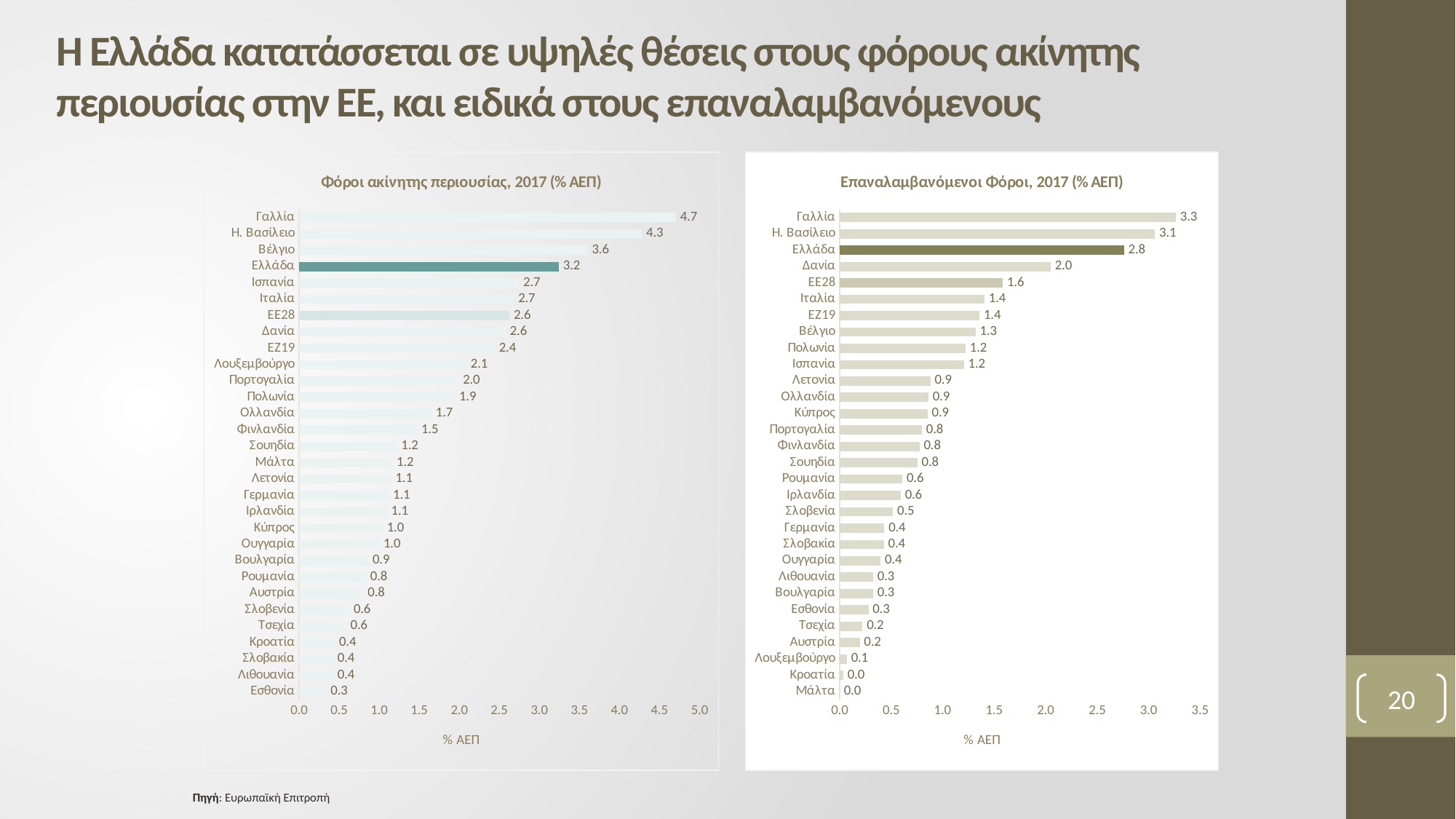
In the chart 'Επαναλαμβανόμενοι Φόροι, 2017 (% ΑΕΠ)', which is larger, Δανία or Ιταλία? Δανία In the chart 'Φόροι ακίνητης περιουσίας, 2017 (% ΑΕΠ)', which country has the highest value? Γαλλία In the chart 'Επαναλαμβανόμενοι Φόροι, 2017 (% ΑΕΠ)', what is the value for ΕΖ19? 1.4 What kind of chart is 'Επαναλαμβανόμενοι Φόροι, 2017 (% ΑΕΠ)'? Bar chart In the chart 'Φόροι ακίνητης περιουσίας, 2017 (% ΑΕΠ)', what is the value for Ελλάδα? 3.2 In the chart 'Φόροι ακίνητης περιουσίας, 2017 (% ΑΕΠ)', which is larger, Βέλγιο or Ισπανία? Βέλγιο In the chart 'Επαναλαμβανόμενοι Φόροι, 2017 (% ΑΕΠ)', which category has the lowest value? Μάλτα and Κροατία (both 0.0) In the chart 'Επαναλαμβανόμενοι Φόροι, 2017 (% ΑΕΠ)', what is the value for Ελλάδα? 2.8 What is the x-axis label of the chart 'Φόροι ακίνητης περιουσίας, 2017 (% ΑΕΠ)'? % ΑΕΠ In the chart 'Φόροι ακίνητης περιουσίας, 2017 (% ΑΕΠ)', what is the difference between Γαλλία and Ελλάδα? 1.5 In the chart 'Επαναλαμβανόμενοι Φόροι, 2017 (% ΑΕΠ)', what is the difference between Ελλάδα and ΕΕ28? 1.2 How many categories are shown in the chart 'Φόροι ακίνητης περιουσίας, 2017 (% ΑΕΠ)'? 30